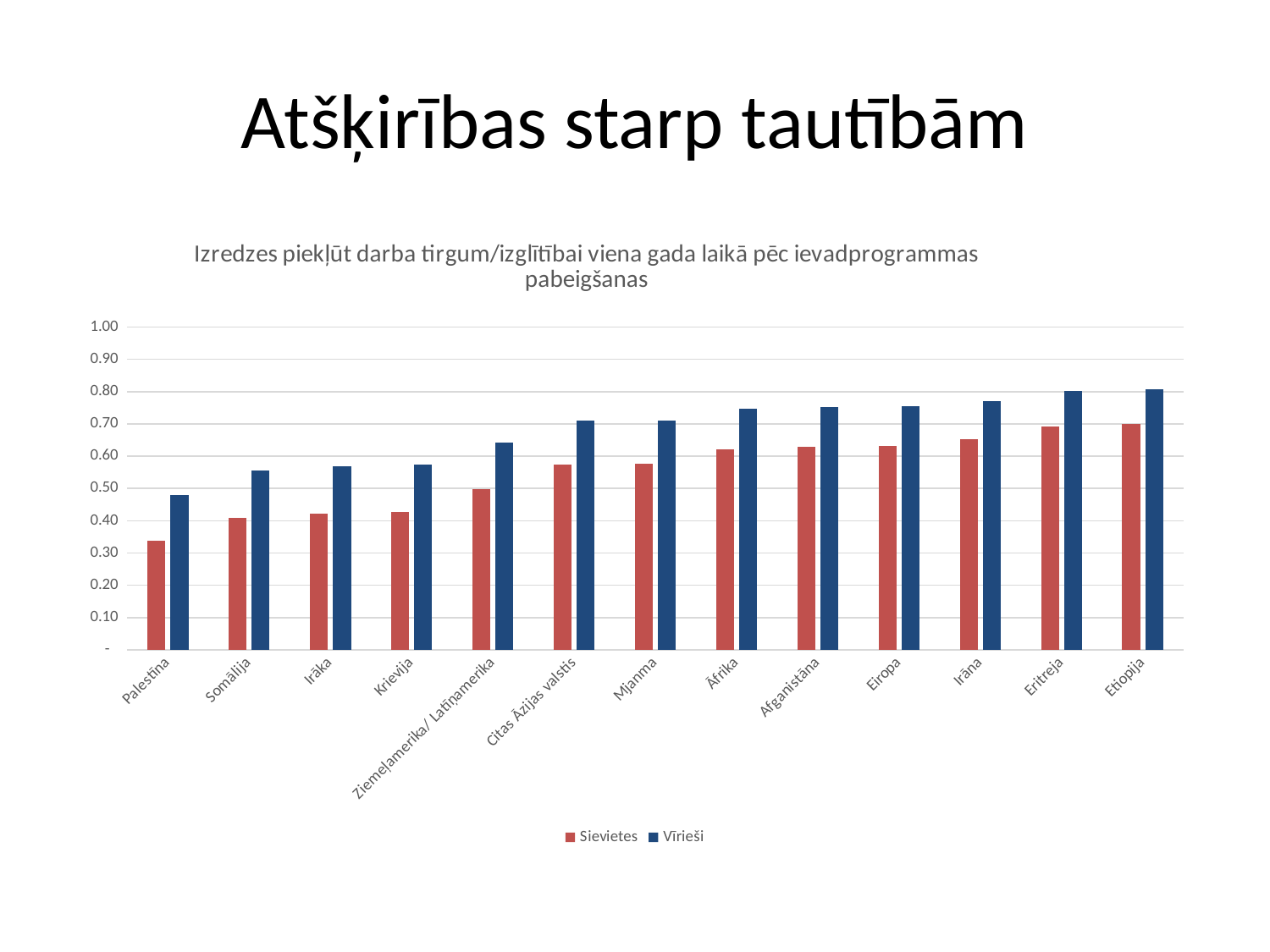
How many series does the legend list? 2 Do the values for Sievietes rise or fall from left to right along the x axis? rise Is the value for Vīrieši in Somālija greater or less than 0.50? greater Is the value for Vīrieši in Āfrika greater or less than 0.70? greater How many categories are shown on the x axis? 13 Which category has the lowest value for Vīrieši? Palestīna Which category has the highest value for Sievietes? Etiopija Is the value for Sievietes in Irāna greater or less than 0.60? greater Which category has the lowest value for Sievietes? Palestīna What kind of chart is shown on the slide? bar chart For Eiropa, which is larger: the value for Sievietes or for Vīrieši? Vīrieši